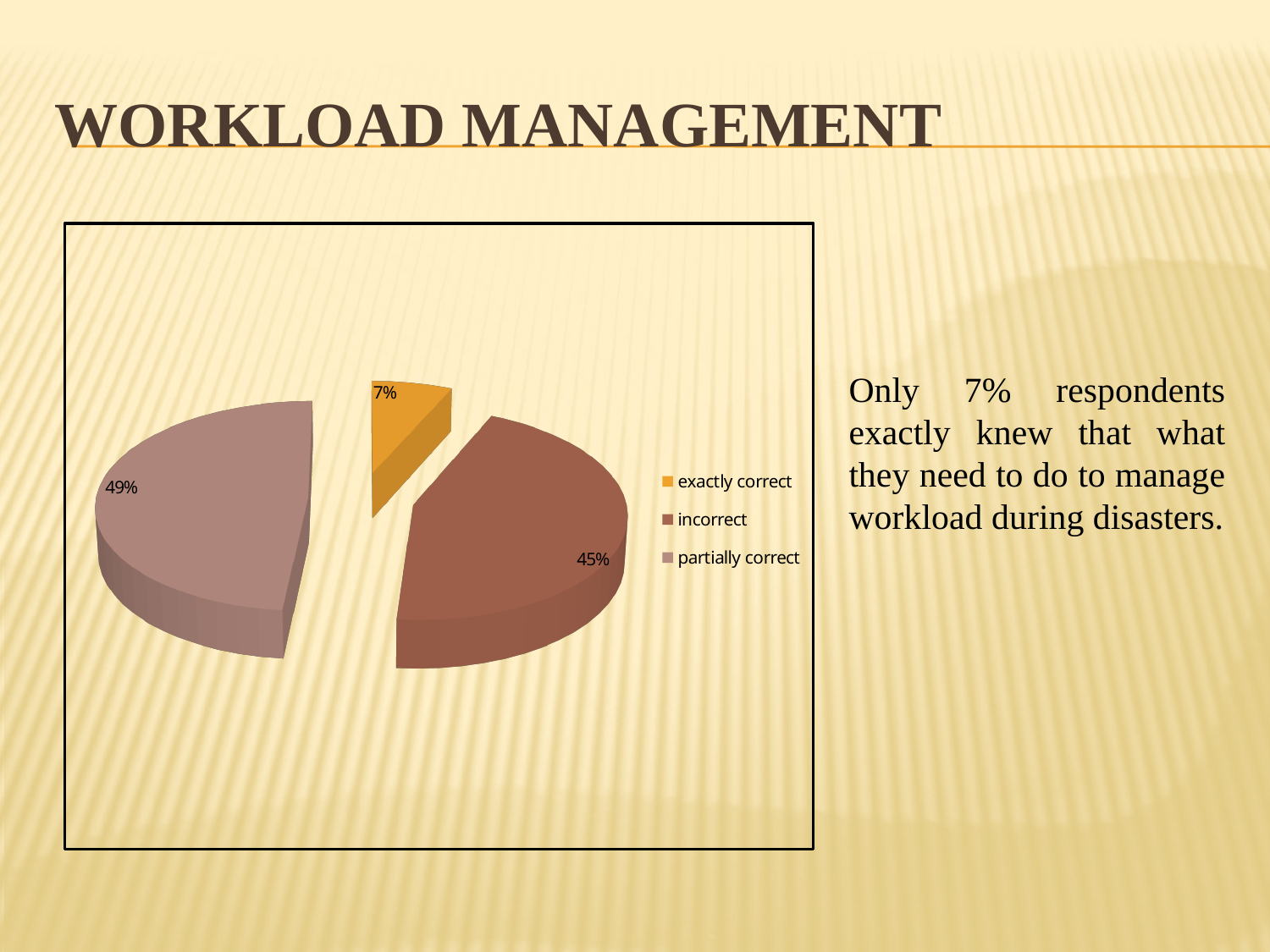
What is the difference in percentage points between the incorrect and exactly correct slices? 38 Which is larger, the incorrect slice or the exactly correct slice? incorrect Which category has the smallest share of the pie? exactly correct What colour is the exactly correct slice? orange Which category has the largest share of the pie? partially correct What kind of chart is shown on the slide? pie chart What is the title of the slide containing the chart? WORKLOAD MANAGEMENT What percentage of respondents were exactly correct? 7% What is the difference in percentage points between the partially correct and incorrect slices? 4 What percentage of respondents were incorrect? 45% What percentage of respondents were partially correct? 49% How many slices does the pie chart have? 3